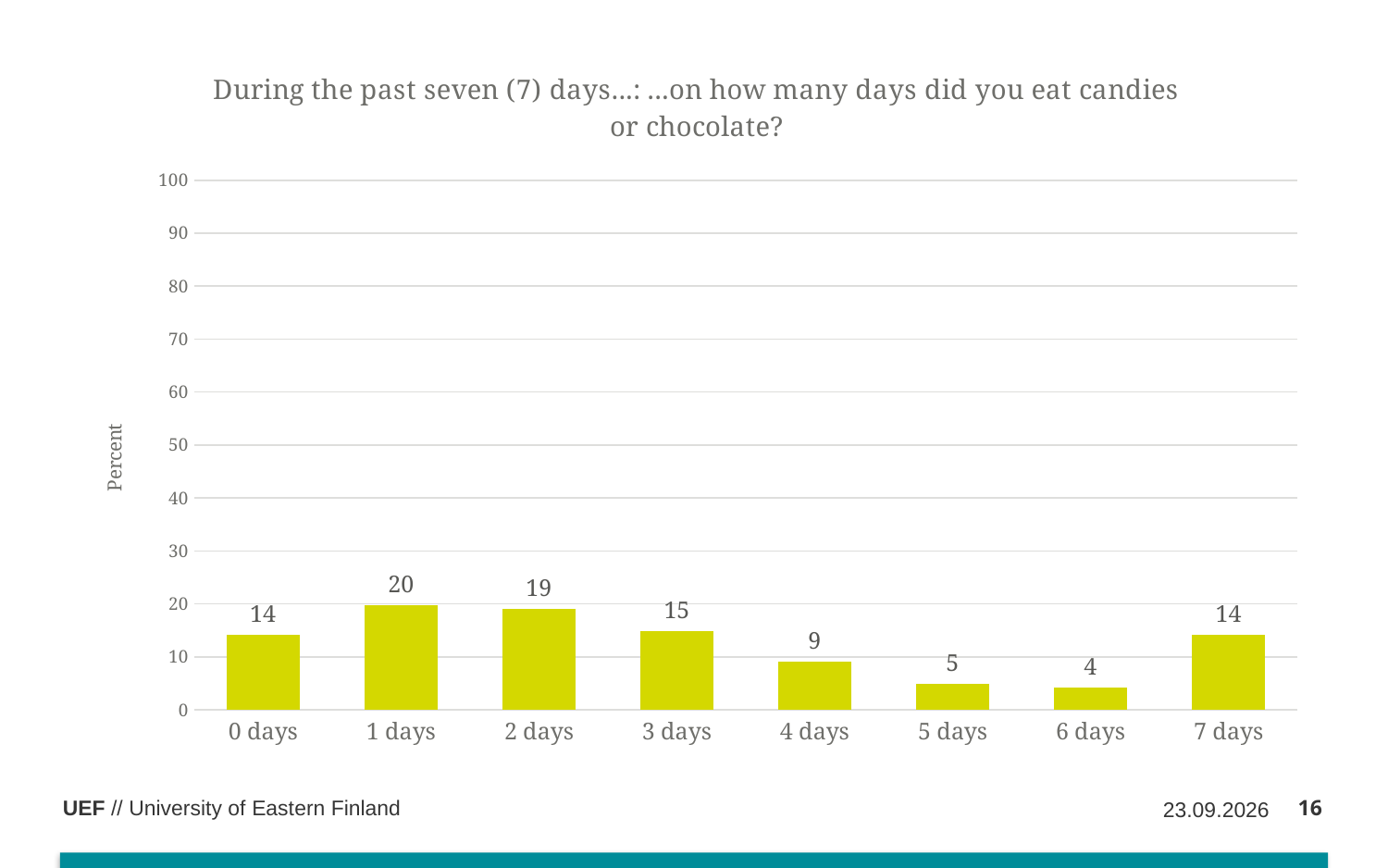
What is the label of the y axis? Percent How many categories are shown on the x axis? 8 What is the difference between the values for 0 days and 7 days? 0 Which category has the highest value? 1 days What kind of chart is this? bar chart What is the value for 7 days? 14 What is the value for 4 days? 9 What is the value for 1 days? 20 What is the difference between the values for 1 days and 6 days? 16 Is the value for 2 days greater or less than 10? greater Which category has the lowest value? 6 days Which is larger, the value for 3 days or the value for 5 days? 3 days